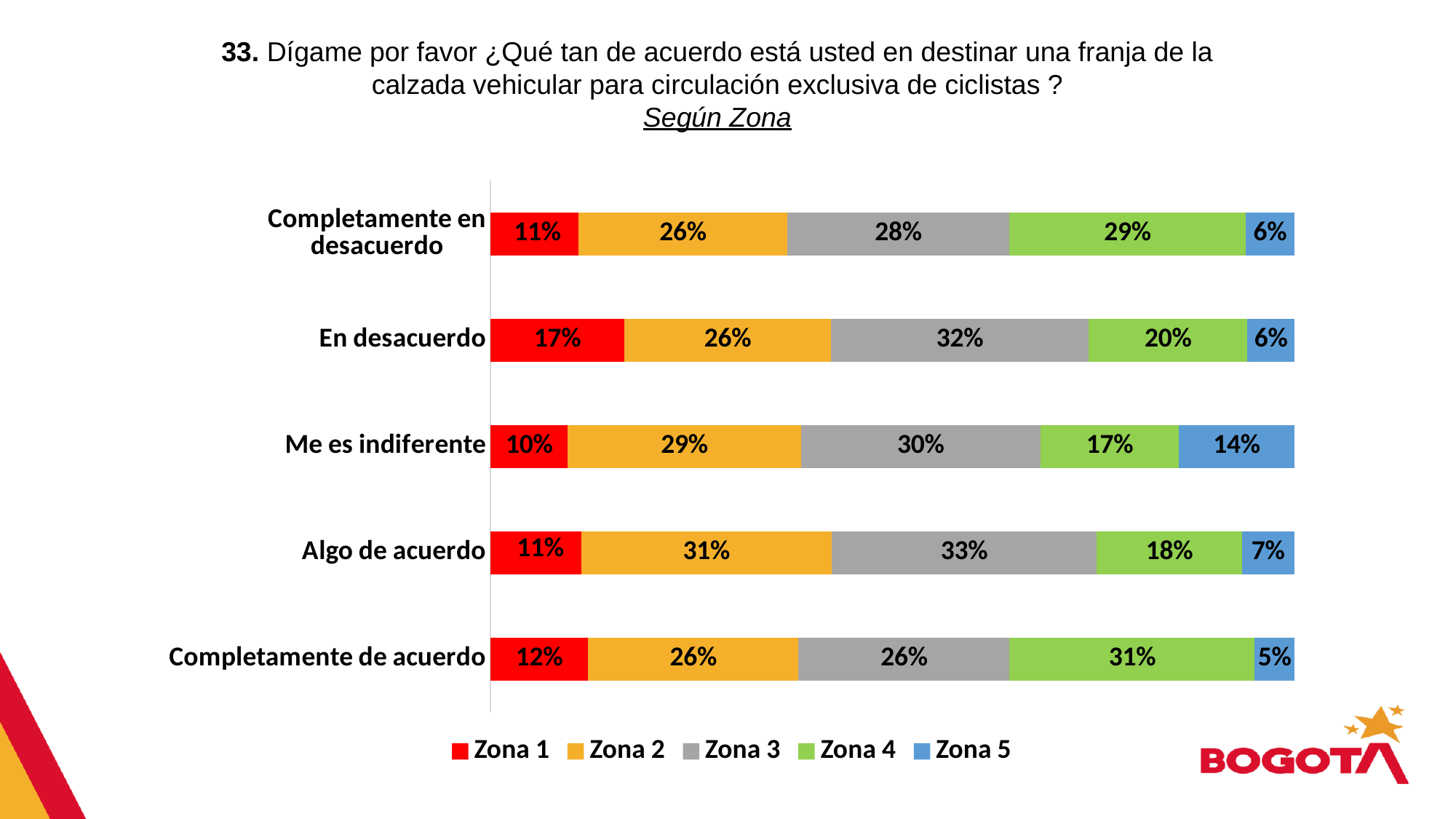
Which is larger: the Zona 2 value for 'Algo de acuerdo' or the Zona 2 value for 'En desacuerdo'? Algo de acuerdo What is the value for Zona 1 in the 'Completamente de acuerdo' bar? 12% What is the difference between the Zona 4 value for 'Completamente de acuerdo' and the Zona 4 value for 'Me es indiferente'? 14 percentage points How many series does the legend list? 5 Which zone has the largest segment in the 'Completamente en desacuerdo' bar? Zona 4 How many response categories are shown on the chart? 5 Which category has the lowest value for Zona 5? Completamente de acuerdo What kind of chart is shown on the slide? Stacked bar chart Which category has the highest value for Zona 1? En desacuerdo What is the value for Zona 3 in the 'Algo de acuerdo' bar? 33% What is the value for Zona 5 in the 'Me es indiferente' bar? 14% What colour represents Zona 4 in the legend? Green